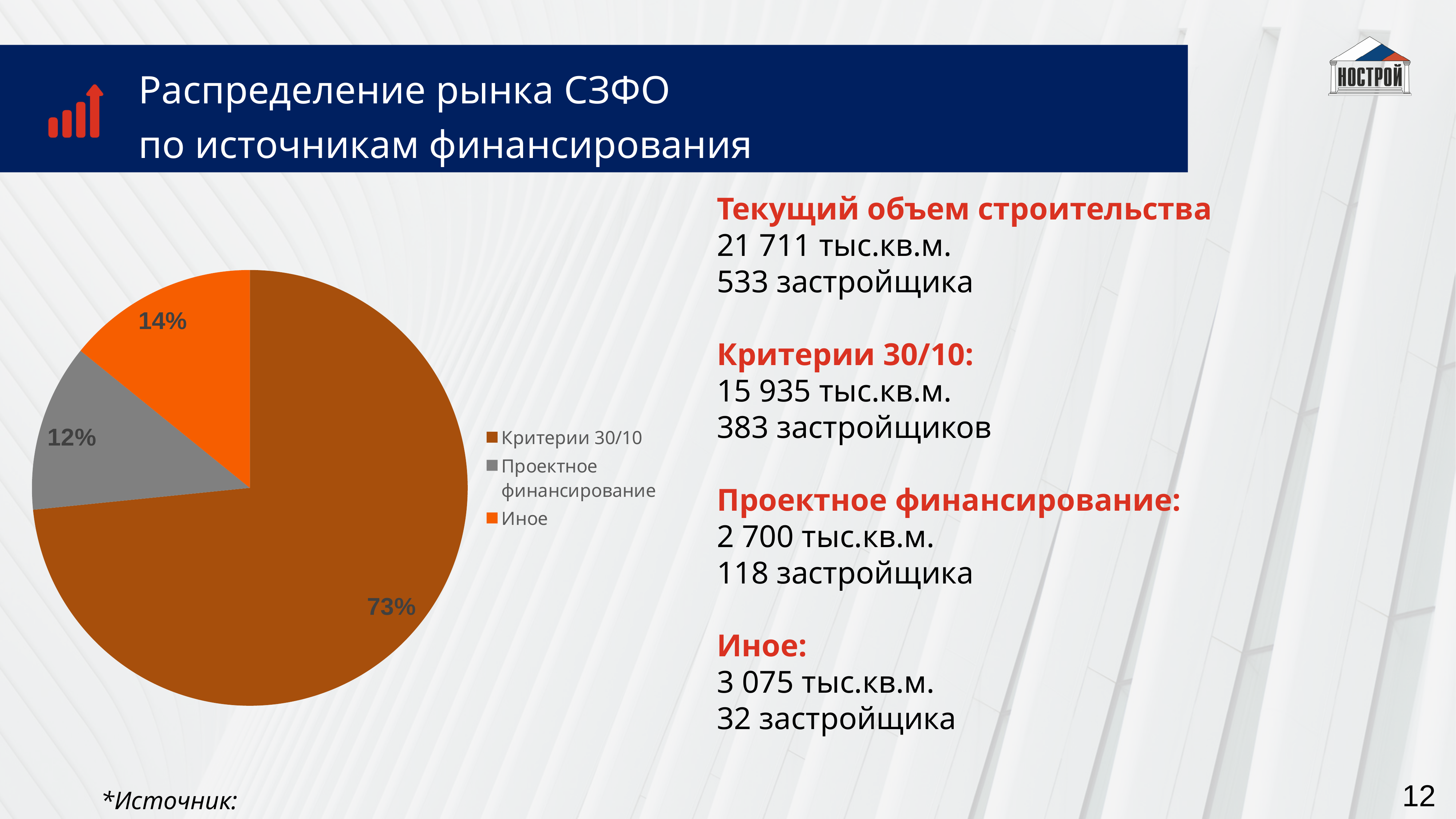
What share of the pie does Иное have? 14% How many slices does the pie chart have? 3 Which category has the largest slice of the pie? Критерии 30/10 What share of the pie does Проектное финансирование have? 12% What is the difference in percentage points between the Критерии 30/10 slice and the Иное slice? 59 How many entries does the legend list? 3 What kind of chart is shown on the slide? pie chart What colour is the Иное slice in the pie chart? orange What share of the pie does Критерии 30/10 have? 73% What colour is the Проектное финансирование slice in the pie chart? grey Which category has the smallest slice of the pie? Проектное финансирование Which slice is larger, Иное or Проектное финансирование? Иное